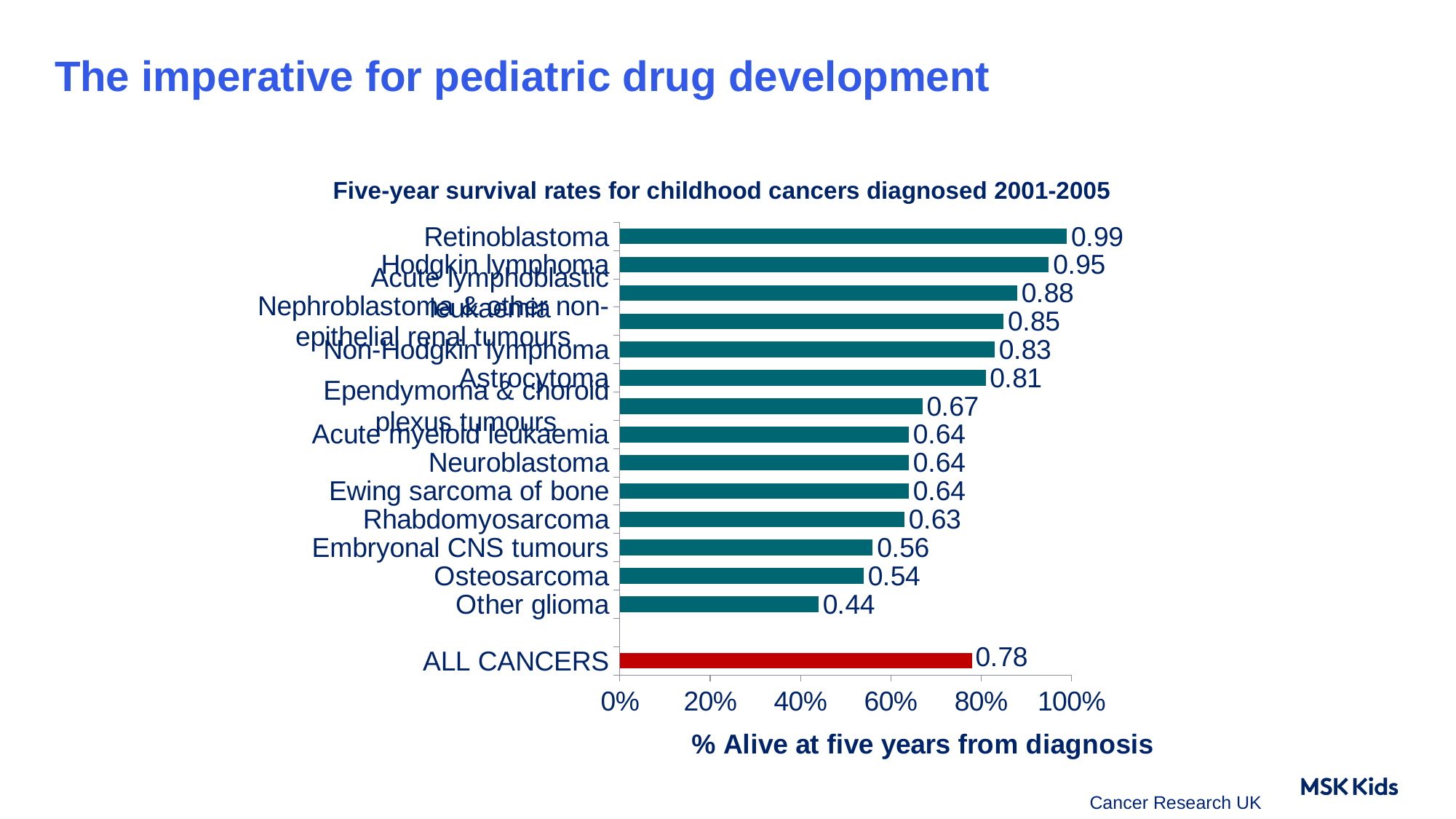
What is the value shown for Other glioma? 0.44 Which category has the lowest five-year survival rate? Other glioma Which category has the highest five-year survival rate? Retinoblastoma Which is larger, the value for Hodgkin lymphoma or the value for Embryonal CNS tumours? Hodgkin lymphoma What is the five-year survival rate shown for Retinoblastoma? 0.99 How many bars are plotted in the chart? 15 What is the title of the chart? Five-year survival rates for childhood cancers diagnosed 2001-2005 Is the value for Rhabdomyosarcoma greater or less than 80%? less What kind of chart is shown on the slide? Bar chart What is the difference between the values for Retinoblastoma and Other glioma? 0.55 What is the value shown for Osteosarcoma? 0.54 What value is shown for ALL CANCERS? 0.78